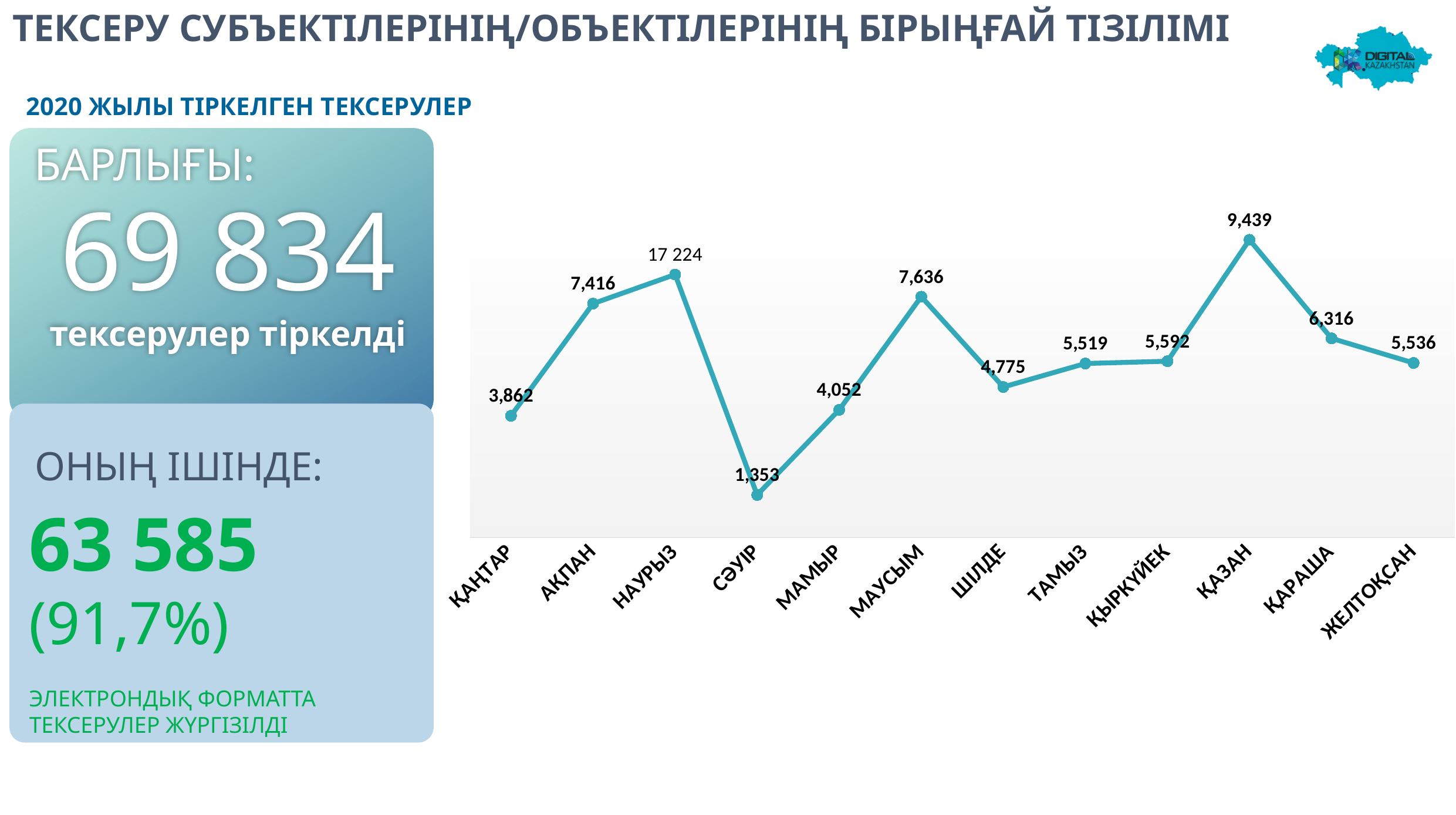
Do the values rise or fall from ҚАЗАН to ЖЕЛТОҚСАН? fall What is the value for ҚАЗАН? 9,439 What is the difference between the values for МАУСЫМ and МАМЫР? 3,584 What is the value for ҚАҢТАР? 3,862 What is the first month label on the x axis of the chart? ҚАҢТАР What is the value for ЖЕЛТОҚСАН? 5,536 Which month has the lowest value on the chart? СӘУІР What is the difference between the values for ҚАЗАН and ҚАҢТАР? 5,577 Which is larger, the value for ҚАРАША or the value for ЖЕЛТОҚСАН? ҚАРАША How many months are plotted on the x axis of the chart? 12 What is the value for СӘУІР? 1,353 What type of chart is shown on the slide? line chart